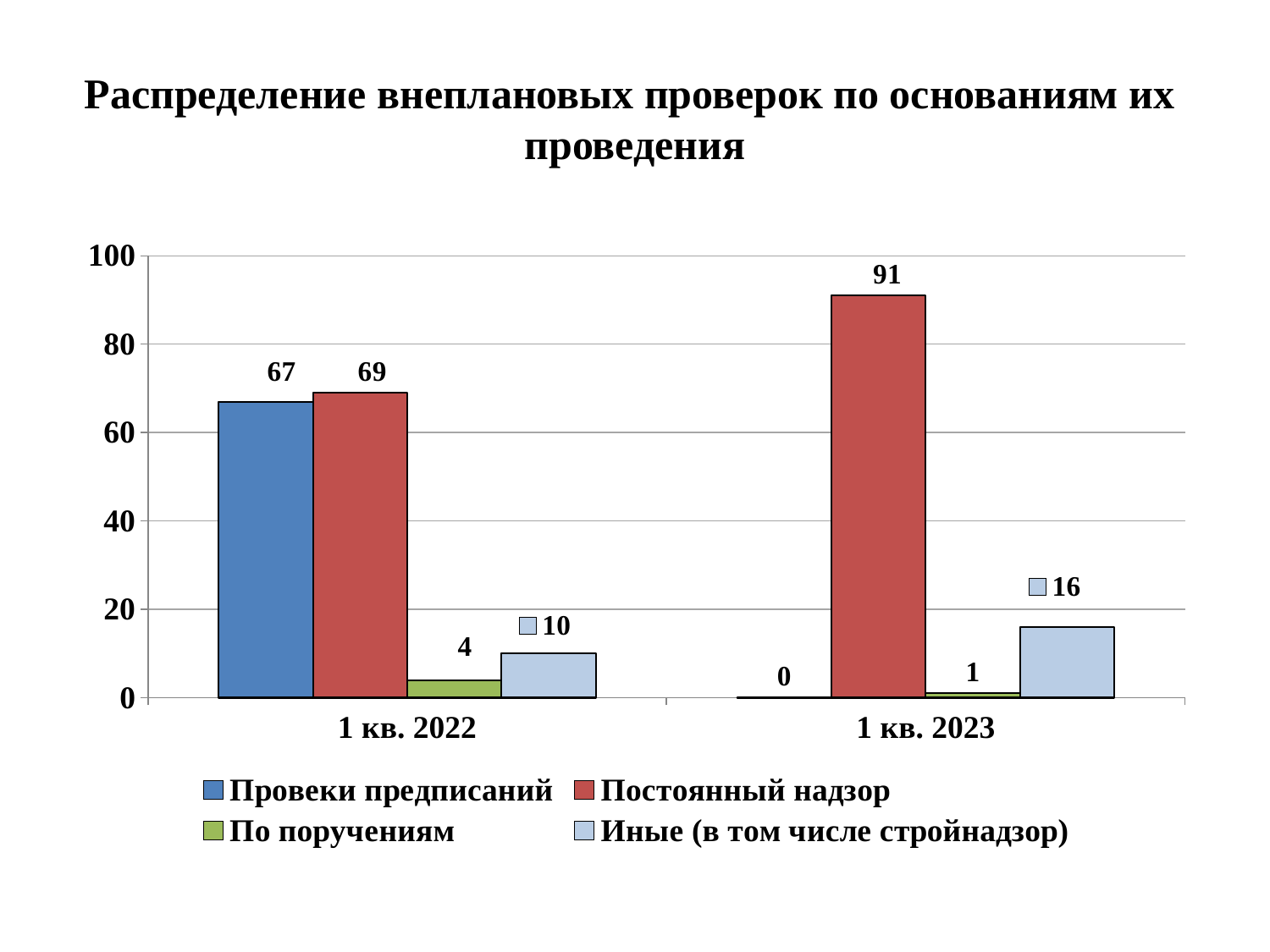
What is the difference between Постоянный надзор in 1 кв. 2023 and in 1 кв. 2022? 22 Which series has the highest value in 1 кв. 2022? Постоянный надзор Which series has the lowest value in 1 кв. 2023? Провеки предписаний What is the value for Иные (в том числе стройнадзор) in 1 кв. 2023? 16 What is the value for Провеки предписаний in 1 кв. 2022? 67 What is the value for Постоянный надзор in 1 кв. 2023? 91 What kind of chart is shown on the slide? bar chart How many series does the legend list? 4 Which is larger: Иные (в том числе стройнадзор) in 1 кв. 2022 or in 1 кв. 2023? 1 кв. 2023 What is the title of the chart? Распределение внеплановых проверок по основаниям их проведения How many categories are shown on the x axis? 2 What is the value for По поручениям in 1 кв. 2022? 4